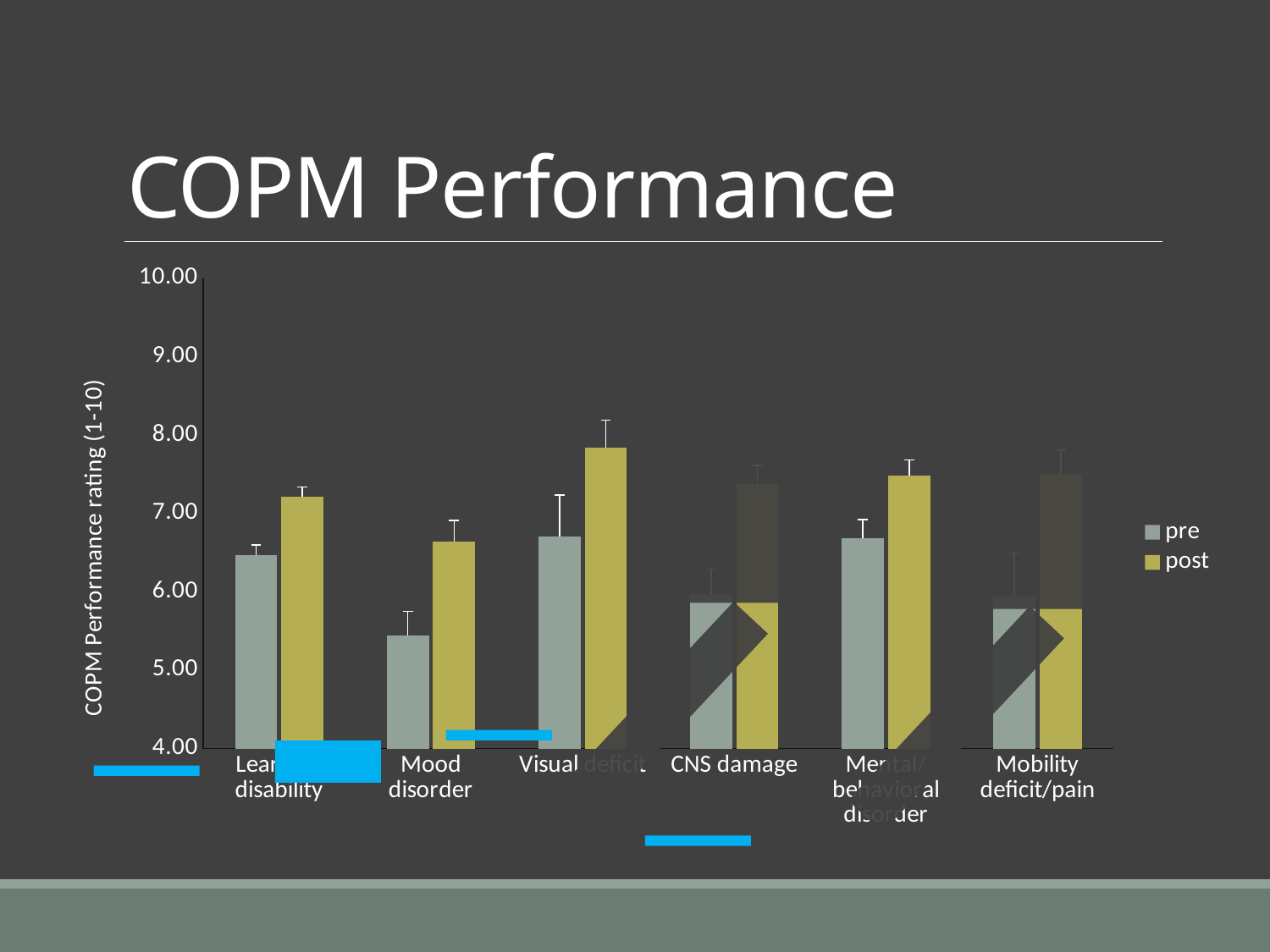
For CNS damage, which is larger, the pre value or the post value? post Is the pre value for Mental/behavioral disorder greater or less than 6.00? greater What kind of chart is shown on the slide? bar chart What is the label of the y axis? COPM Performance rating (1-10) Which category has the lowest pre value? Mood disorder Which category has the lowest post value? Mood disorder How many categories are shown on the x axis? 6 Is the post value for CNS damage greater or less than 7.00? greater Which category has the highest post value? Visual deficit How many series does the legend list? 2 Is the post value for Visual deficit greater or less than 7.00? greater